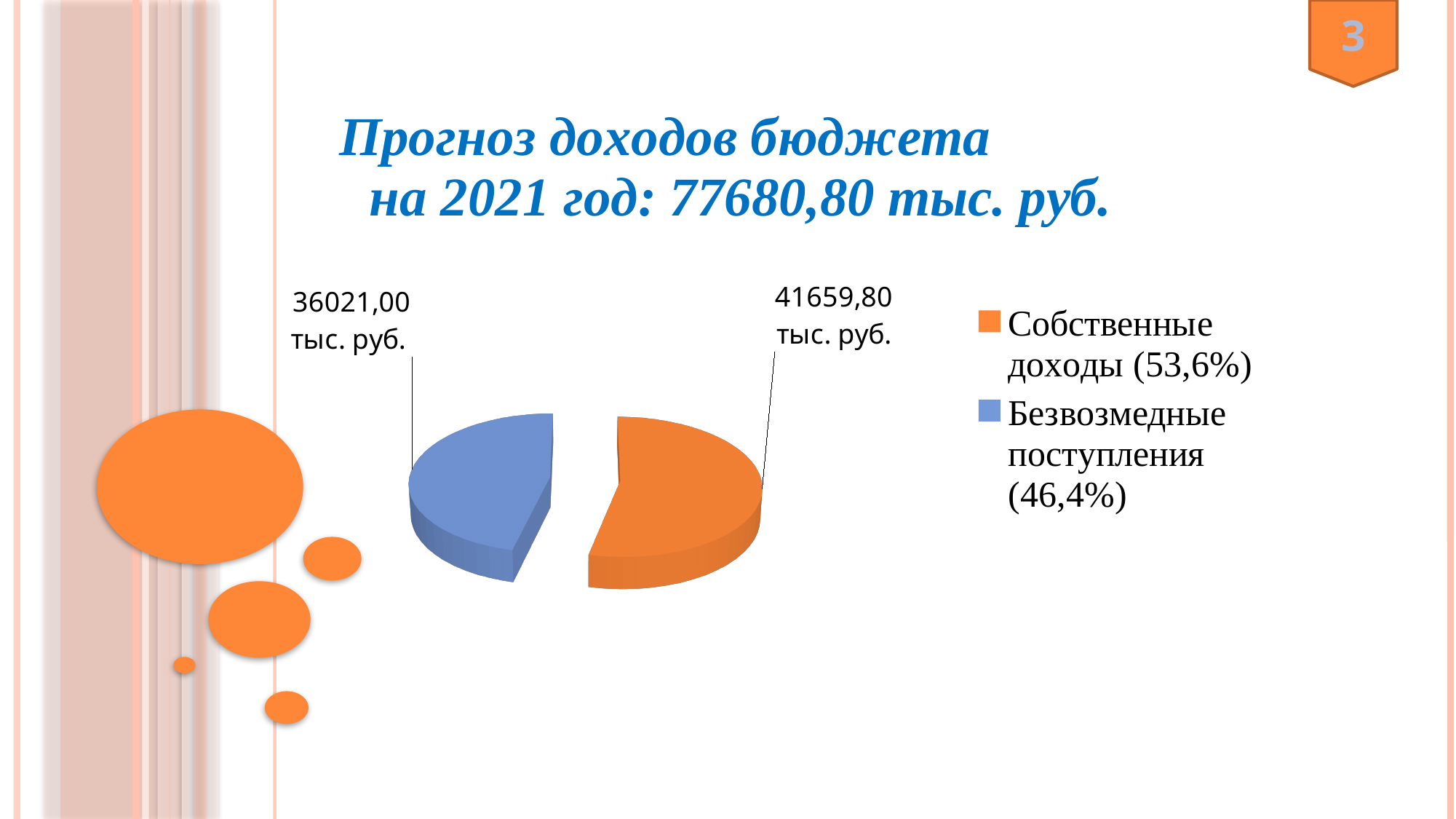
What is the total of the two slices shown in the pie chart? 77680,80 тыс. руб. What is the value shown for Собственные доходы? 41659,80 тыс. руб. What kind of chart is shown on the slide? pie chart What share of the pie does Собственные доходы represent? 53,6% What colour is the slice for Безвозмедные поступления? blue Which slice of the pie is the largest? Собственные доходы Which is larger: Собственные доходы or Безвозмедные поступления? Собственные доходы How many slices does the pie chart have? 2 Which slice of the pie is the smallest? Безвозмедные поступления What is the difference between Собственные доходы and Безвозмедные поступления? 5638,80 тыс. руб. What share of the pie does Безвозмедные поступления represent? 46,4% What is the value shown for Безвозмедные поступления? 36021,00 тыс. руб.